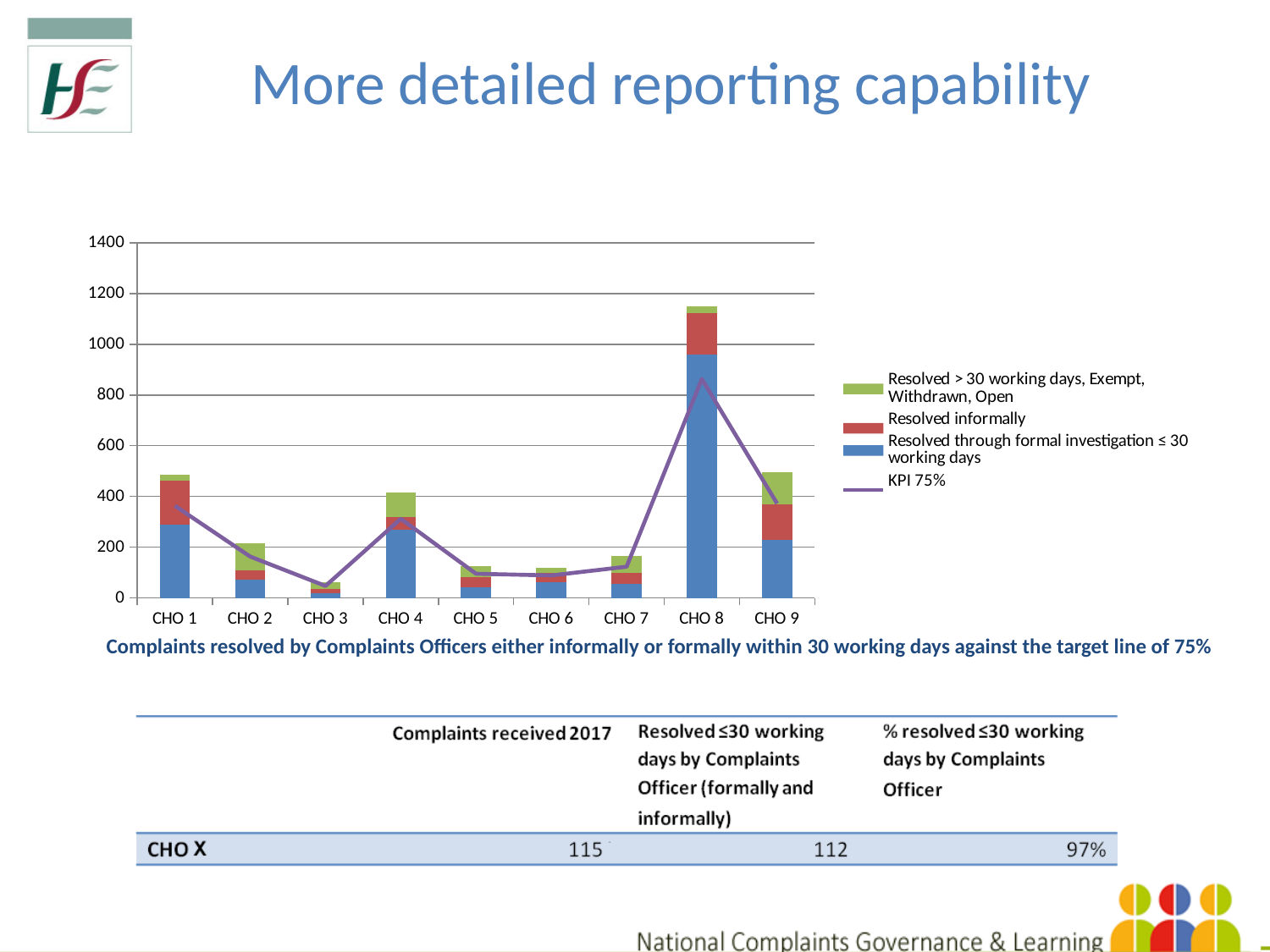
How many CHO categories are shown on the x axis of the chart? 9 Which CHO has the shortest stacked bar in the chart? CHO 3 Which CHO has the tallest stacked bar in the chart? CHO 8 Is the total height of the stacked bar for CHO 5 greater or less than 200? less What is the legend label of the line series plotted on the chart? KPI 75% Is the total height of the stacked bar for CHO 2 greater or less than 400? less How many entries does the chart's legend list? 4 Which has the taller stacked bar, CHO 1 or CHO 2? CHO 1 Which has the taller stacked bar, CHO 8 or CHO 9? CHO 8 Is the total height of the stacked bar for CHO 1 greater or less than 400? greater What kind of chart is shown on the slide? Stacked bar chart with a line